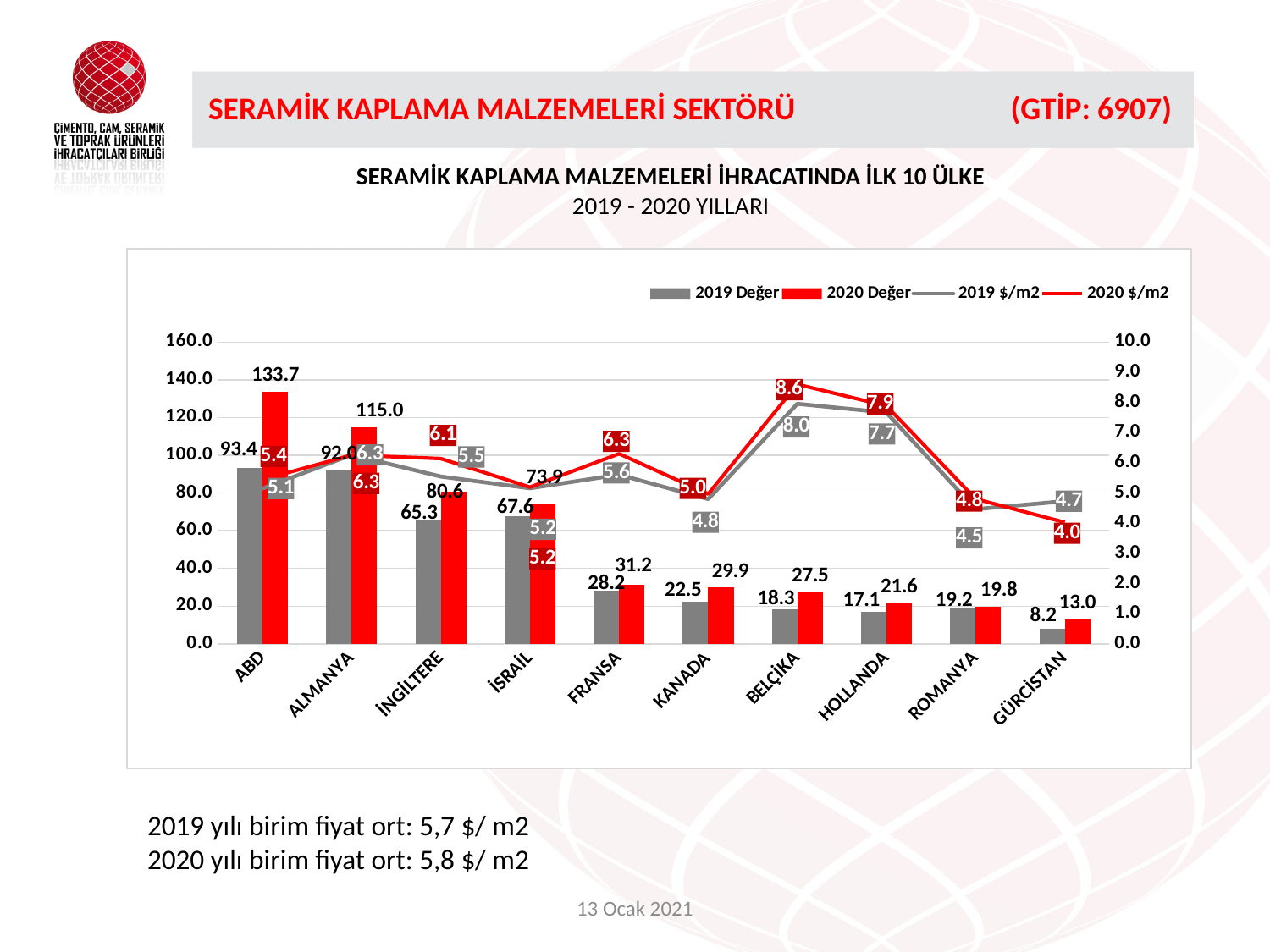
Which country has the lowest 2019 Değer bar? GÜRCİSTAN What is the difference between the 2020 Değer and 2019 Değer values for ABD? 40.3 Which country has the highest 2020 Değer bar? ABD What is the 2019 Değer value for ALMANYA? 92.0 What is the 2019 $/m2 value for GÜRCİSTAN? 4.7 What is the 2020 $/m2 value for BELÇİKA? 8.6 How many series does the legend list? 4 Which is larger for İSRAİL: the 2019 Değer or the 2020 Değer? 2020 Değer How many countries are shown on the x axis? 10 What is the 2020 Değer value for ABD? 133.7 What kind of chart is used for the 2019 Değer and 2020 Değer series? Bar chart Is the 2020 Değer value for İNGİLTERE greater or less than 100.0? less